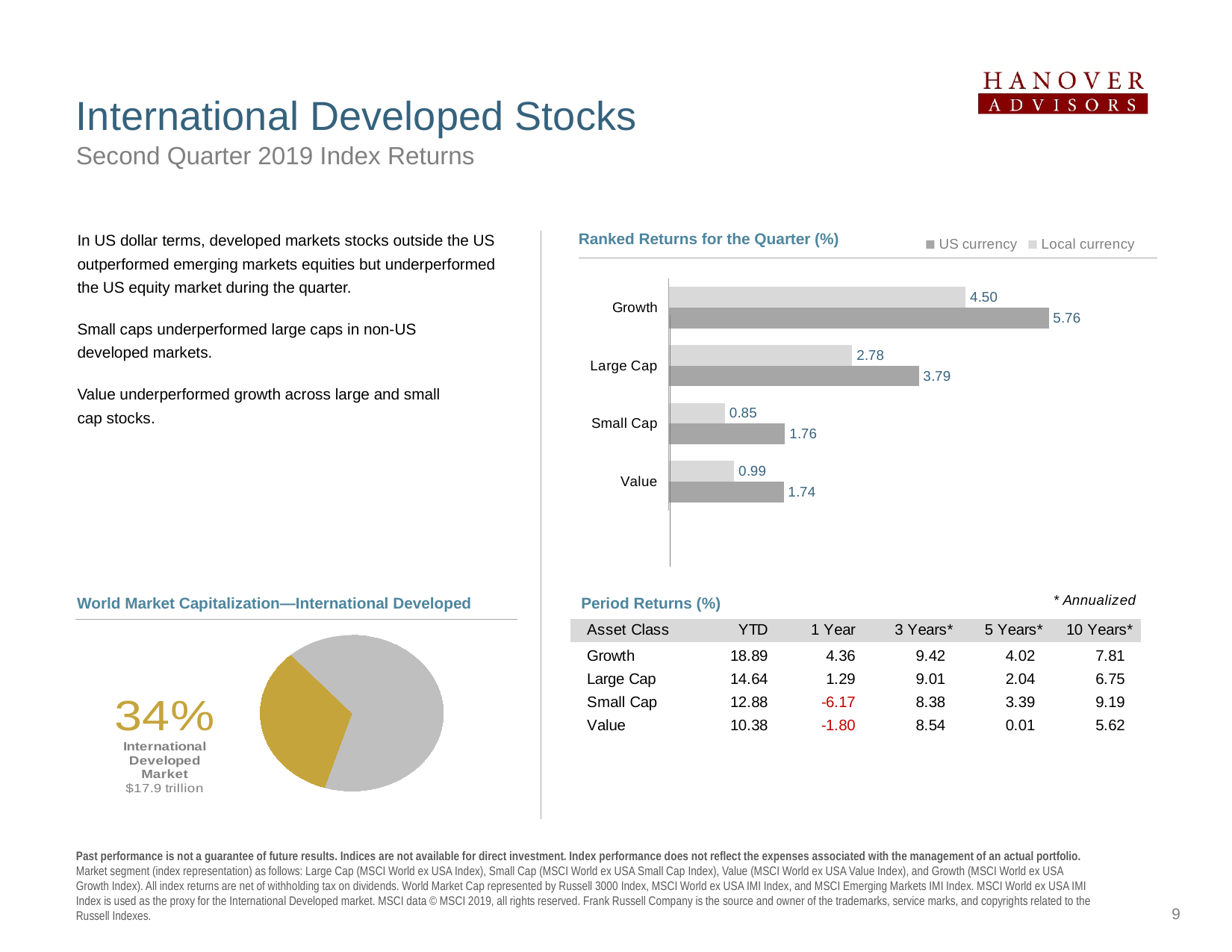
In the Ranked Returns for the Quarter chart, which category has the highest US currency return? Growth In the Ranked Returns for the Quarter chart, which is larger: the Local currency return for Large Cap or the US currency return for Small Cap? Local currency return for Large Cap In the Ranked Returns for the Quarter chart, which category has the lowest Local currency return? Small Cap In the Ranked Returns for the Quarter chart, what is the difference between the US currency and Local currency returns for Growth? 1.26 In the Ranked Returns for the Quarter chart, what is the Local currency return for Value? 0.99 In the Ranked Returns for the Quarter chart, what is the Local currency return for Large Cap? 2.78 How many series does the legend of the Ranked Returns for the Quarter chart list? 2 In the Ranked Returns for the Quarter chart, what is the US currency return for Small Cap? 1.76 What kind of chart is the Ranked Returns for the Quarter chart? Bar chart In the World Market Capitalization—International Developed pie chart, what share does the International Developed Market represent? 34% How many categories are shown in the Ranked Returns for the Quarter chart? 4 In the Ranked Returns for the Quarter chart, what is the US currency return for Growth? 5.76